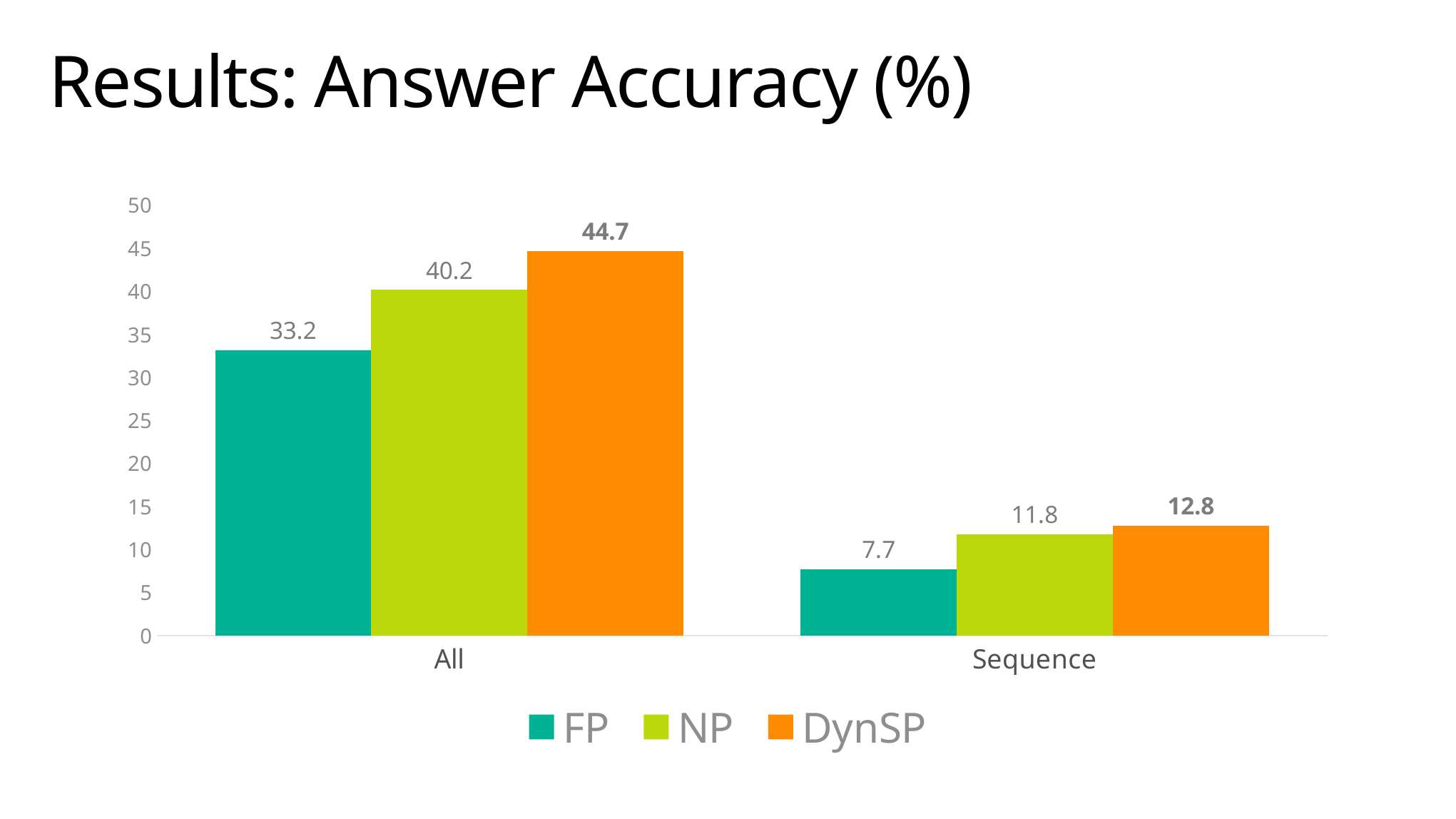
What kind of chart is shown on the slide? bar chart How many categories are shown on the x axis? 2 Is the value for NP on Sequence greater or less than 10? greater Which is larger: NP on All or DynSP on All? DynSP on All What is the answer accuracy of FP on the Sequence category? 7.7 What is the answer accuracy of NP on the All category? 40.2 Which series has the lowest value for the All category? FP Which series has the highest value for the Sequence category? DynSP How many series does the legend list? 3 What is the difference between NP and FP on the Sequence category? 4.1 What is the difference between DynSP and FP on the All category? 11.5 What is the answer accuracy of DynSP on the All category? 44.7